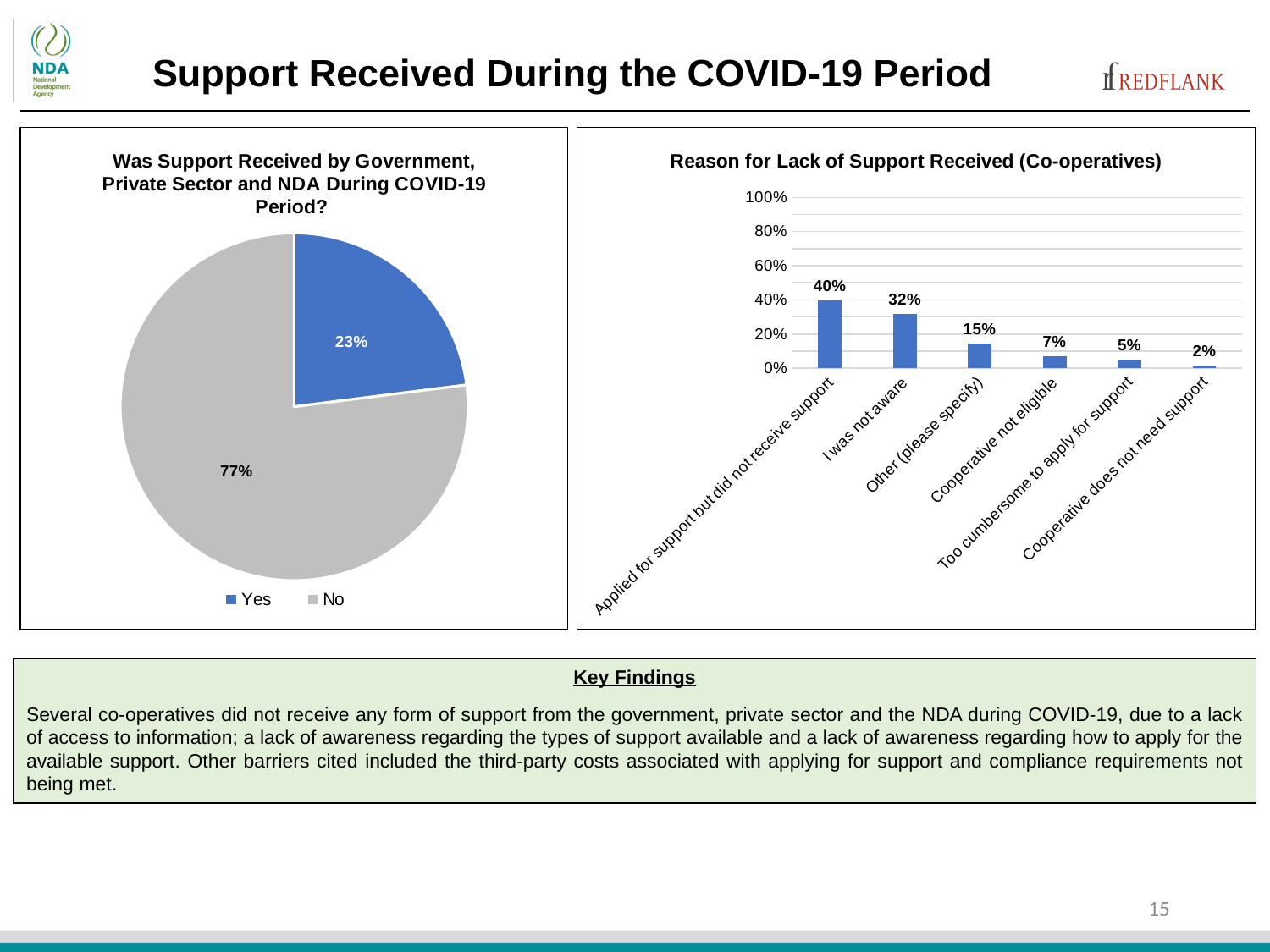
In the 'Reason for Lack of Support Received (Co-operatives)' chart, what is the value for 'I was not aware'? 32% In the pie chart on the left, what share of respondents answered Yes? 23% In the pie chart on the left, what share of respondents answered No? 77% What kind of chart is the chart on the left? Pie chart In the 'Reason for Lack of Support Received (Co-operatives)' chart, which reason has the highest value? Applied for support but did not receive support What kind of chart is the 'Reason for Lack of Support Received (Co-operatives)' chart? Bar chart How many reasons are shown in the 'Reason for Lack of Support Received (Co-operatives)' chart? 6 In the pie chart on the left, what is the difference between the No share and the Yes share? 54% In the 'Reason for Lack of Support Received (Co-operatives)' chart, what is the value for 'Cooperative not eligible'? 7% In the 'Reason for Lack of Support Received (Co-operatives)' chart, which reason has the lowest value? Cooperative does not need support In the pie chart on the left, which answer has the larger share, Yes or No? No In the 'Reason for Lack of Support Received (Co-operatives)' chart, what is the difference between 'Applied for support but did not receive support' and 'Other (please specify)'? 25%